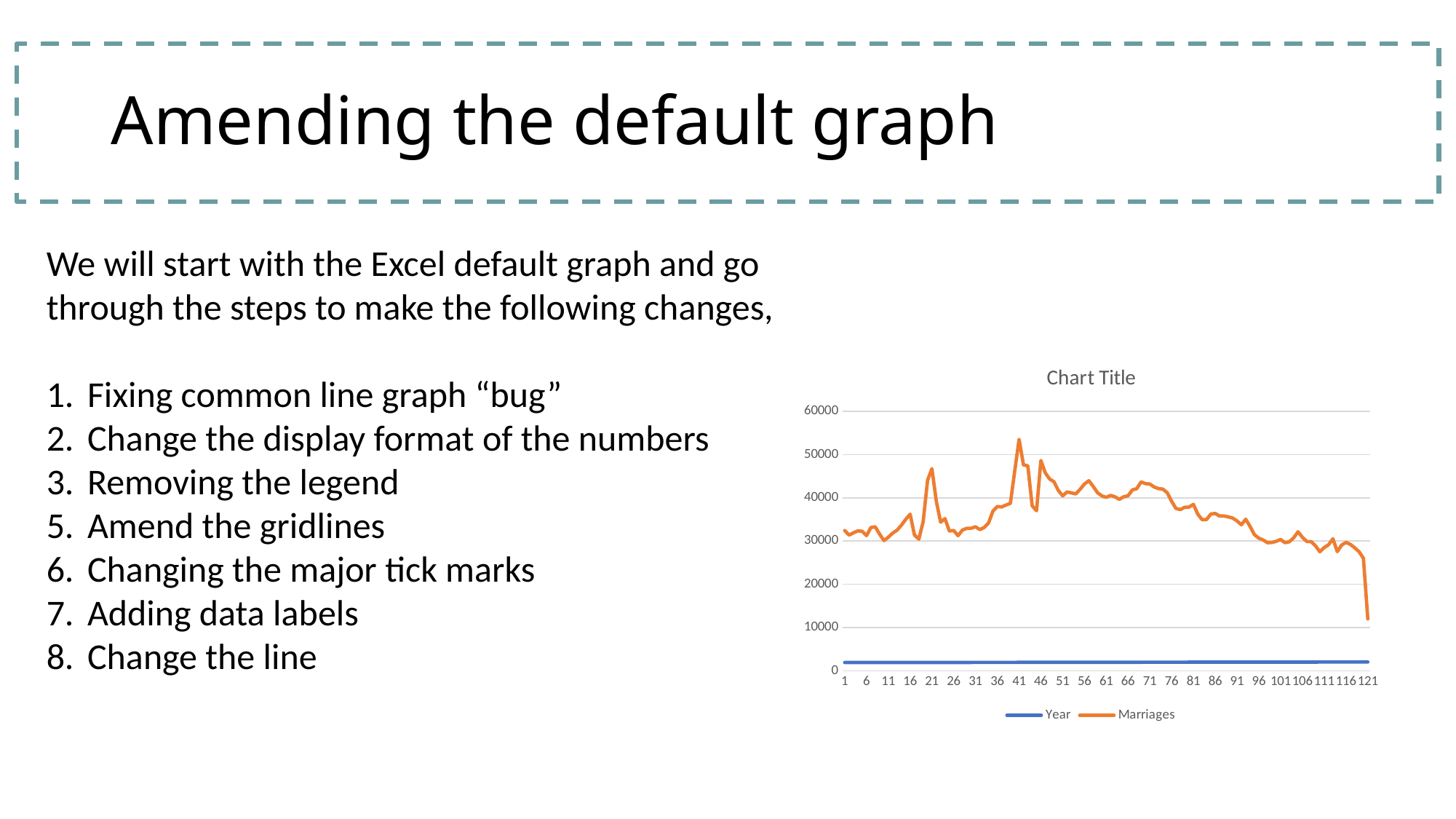
Is the value of the Marriages series at point 121 greater or less than 20000? less How many series does the chart's legend list? 2 Is the peak value of the Marriages series greater or less than 50000? greater What is the title of the chart? Chart Title Which two series are listed in the chart's legend? Year and Marriages Does the Marriages series rise or fall between point 71 and point 121? fall Is the value of the Year series greater or less than 10000? less At which x-axis point does the Marriages series reach its lowest value? 121 Which series has the higher values throughout the chart, Year or Marriages? Marriages What kind of chart is shown on the slide? line chart